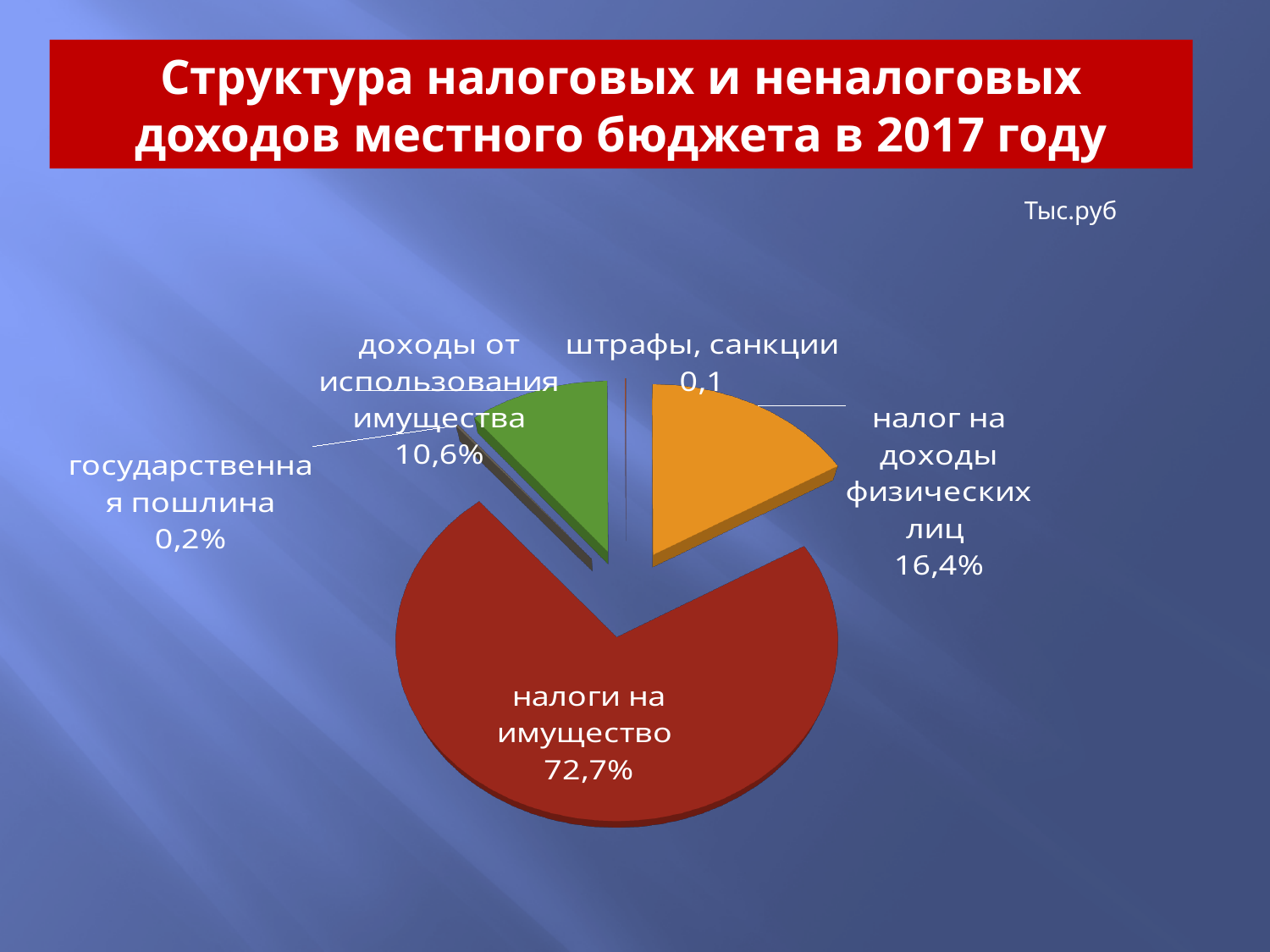
What value is shown for налог на доходы физических лиц? 16,4% What kind of chart is shown on the slide? pie chart What is the difference in percentage points between налоги на имущество and налог на доходы физических лиц? 56,3 What value is printed for штрафы, санкции? 0,1 Which category has the largest slice of the pie? налоги на имущество Which category has the smallest slice of the pie? штрафы, санкции What value is shown for доходы от использования имущества? 10,6% How many categories are shown in the pie chart? 5 What value is shown for государственная пошлина? 0,2% What share of the pie does налоги на имущество account for? 72,7% Which is larger: налог на доходы физических лиц or доходы от использования имущества? налог на доходы физических лиц What is the title of the chart on the slide? Структура налоговых и неналоговых доходов местного бюджета в 2017 году